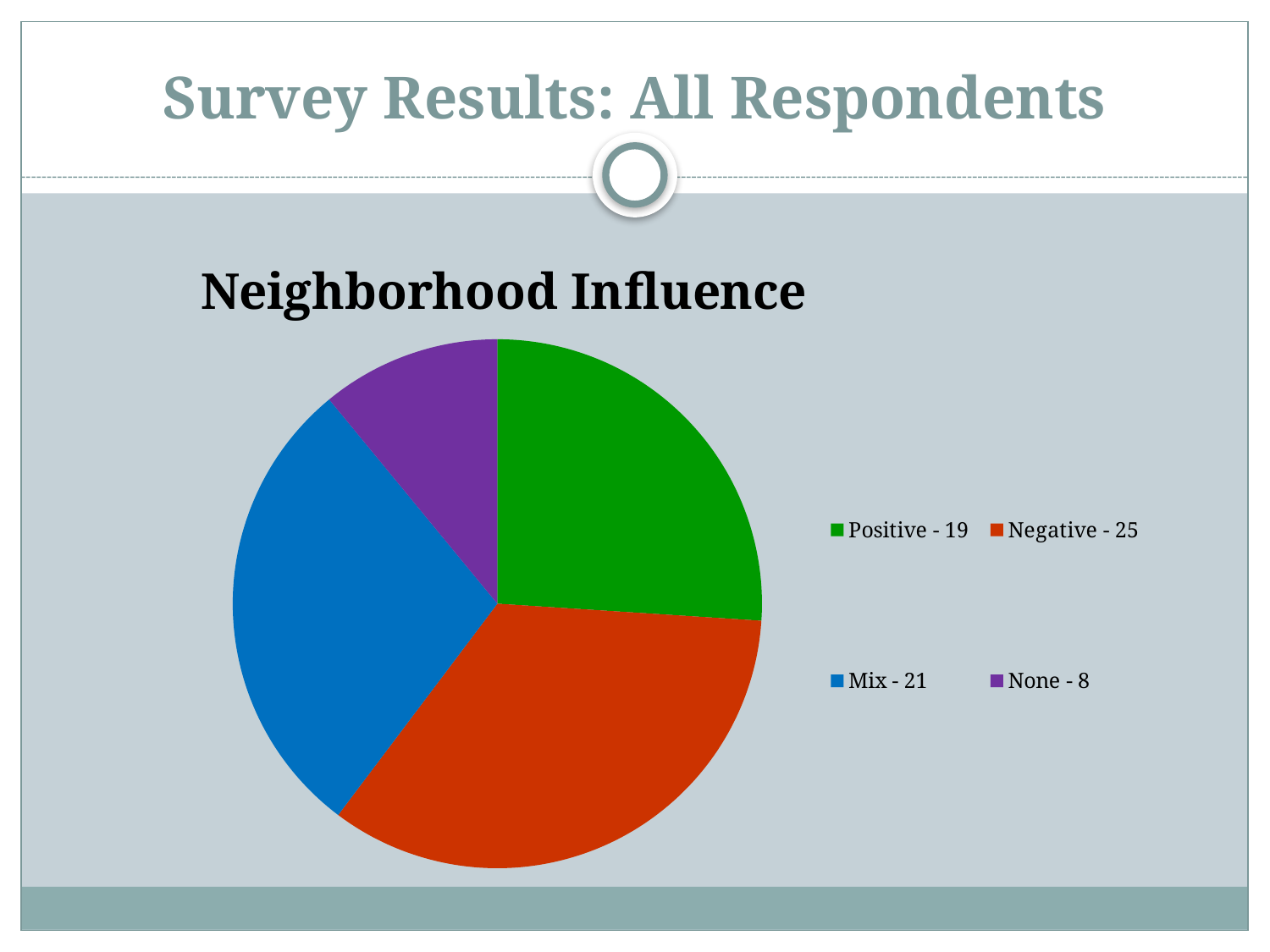
What is the value for Negative? 25 Which category has the smallest slice? None What is the value for Positive? 19 What is the value for Mix? 21 What colour is the Mix slice? Blue What kind of chart is shown on the slide? Pie chart Which category has the largest slice? Negative How many slices does the pie chart have? 4 What is the value for None? 8 What is the title of the chart? Neighborhood Influence Which is larger, Mix or Positive? Mix What is the difference between the Negative and Positive values? 6